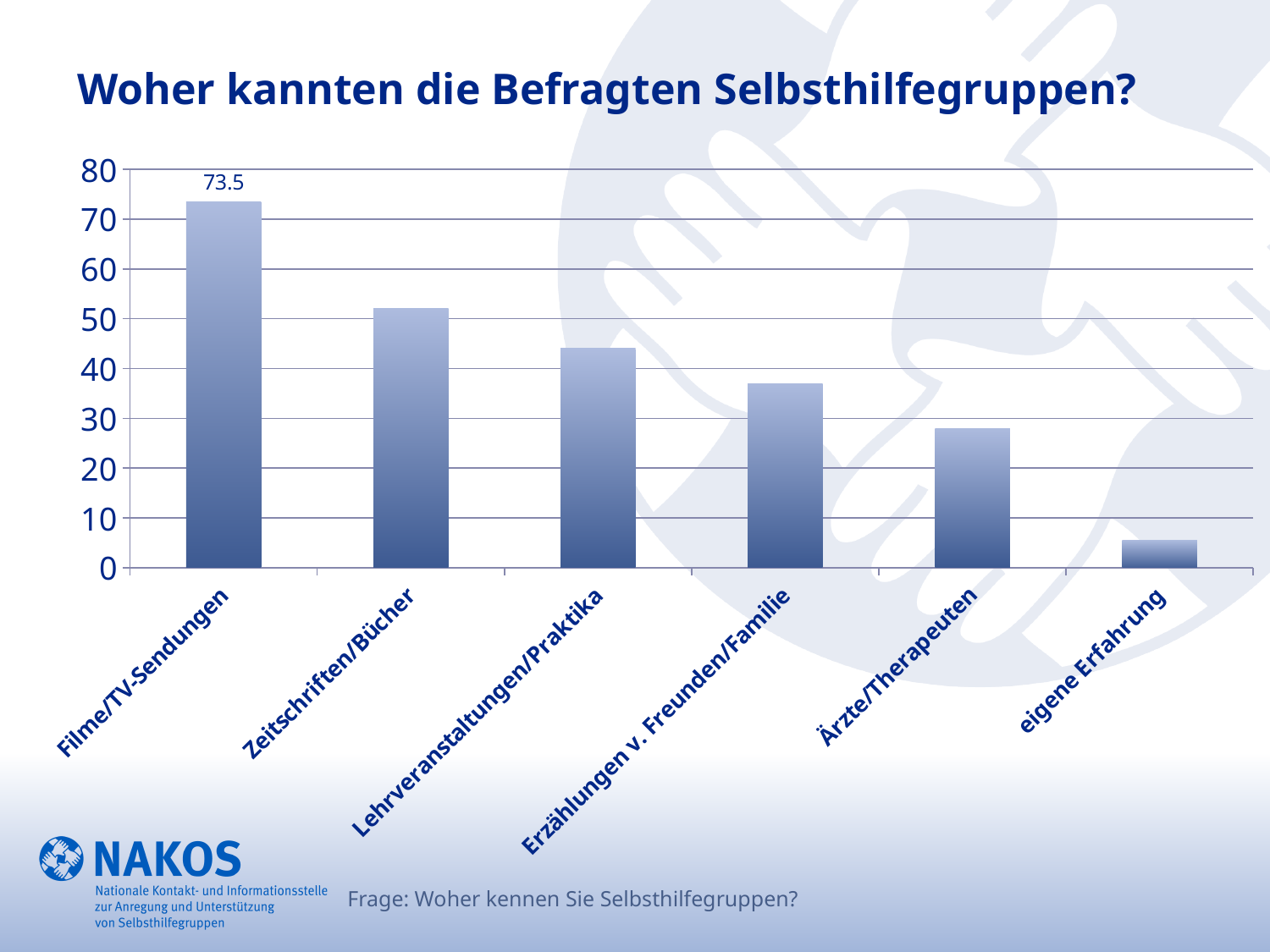
Is the value for eigene Erfahrung greater or less than 10? less Is the value for Zeitschriften/Bücher greater or less than 50? greater Is the value for Lehrveranstaltungen/Praktika greater or less than 50? less Which category has the lowest value? eigene Erfahrung Do the values rise or fall from left to right along the x axis? fall What is the title of the chart? Woher kannten die Befragten Selbsthilfegruppen? What is the value for Filme/TV-Sendungen? 73.5 Which is larger, the value for Erzählungen v. Freunden/Familie or the value for Ärzte/Therapeuten? Erzählungen v. Freunden/Familie What kind of chart is shown on the slide? bar chart How many categories are shown on the x axis? 6 Which category has the highest value? Filme/TV-Sendungen